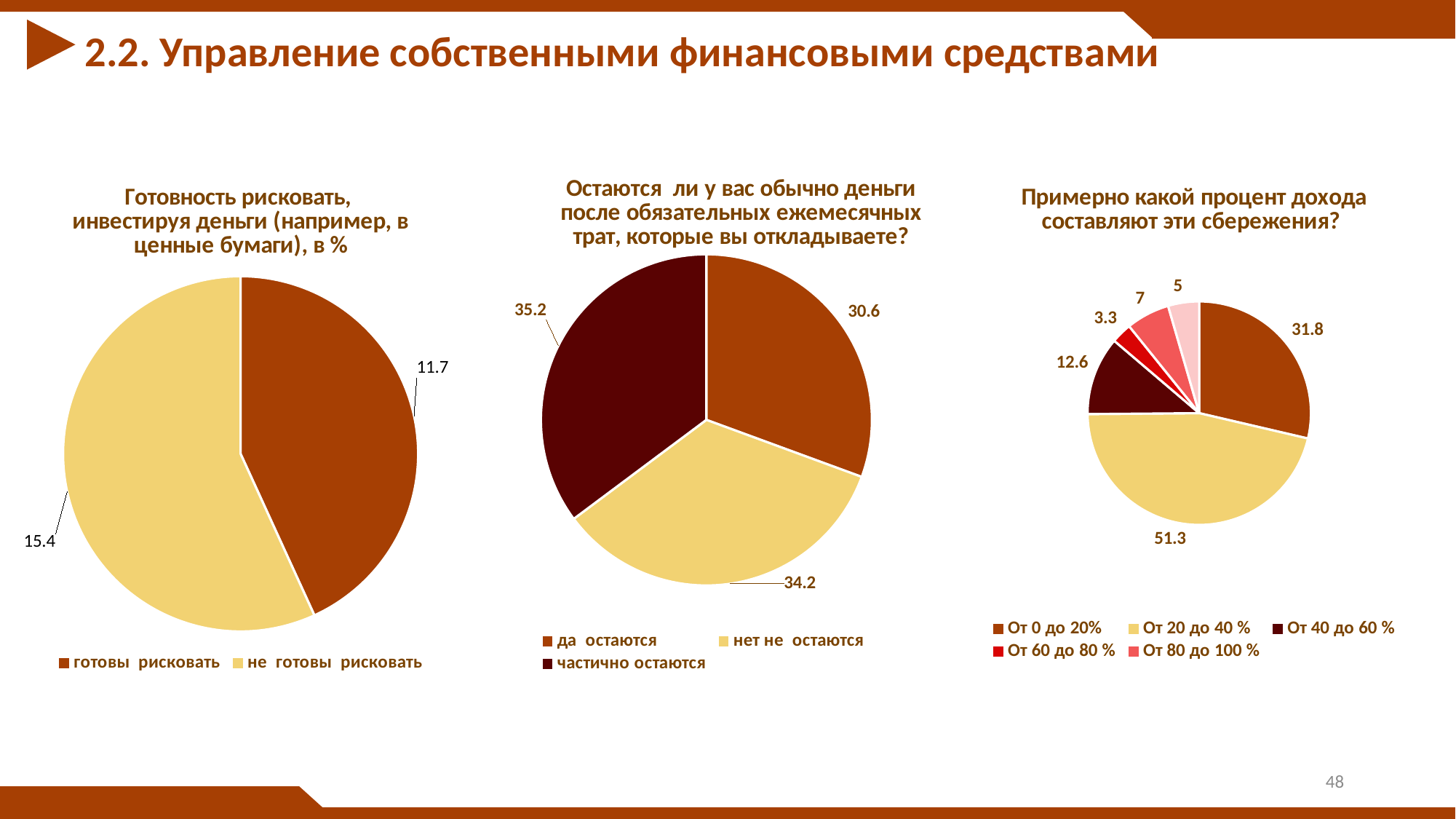
In the left chart (Готовность рисковать, инвестируя деньги), what is the value for "не готовы рисковать"? 15.4 In the left chart (Готовность рисковать, инвестируя деньги), what is the value for "готовы рисковать"? 11.7 In the right chart (Примерно какой процент дохода составляют эти сбережения?), which category has the highest value? От 20 до 40 % In the right chart (Примерно какой процент дохода составляют эти сбережения?), what is the value for "От 20 до 40 %"? 51.3 In the middle chart (Остаются ли у вас обычно деньги после обязательных ежемесячных трат), what is the value for "частично остаются"? 35.2 In the right chart (Примерно какой процент дохода составляют эти сбережения?), which is larger: "От 40 до 60 %" or "От 60 до 80 %"? От 40 до 60 % What kind of chart is the middle chart (Остаются ли у вас обычно деньги после обязательных ежемесячных трат)? pie chart In the middle chart (Остаются ли у вас обычно деньги после обязательных ежемесячных трат), what is the difference between "частично остаются" and "да остаются"? 4.6 In the right chart (Примерно какой процент дохода составляют эти сбережения?), what is the difference between "От 20 до 40 %" and "От 0 до 20%"? 19.5 In the left chart (Готовность рисковать, инвестируя деньги), what is the difference between "не готовы рисковать" and "готовы рисковать"? 3.7 In the middle chart (Остаются ли у вас обычно деньги после обязательных ежемесячных трат), which category has the lowest value? да остаются How many categories does the legend of the middle chart (Остаются ли у вас обычно деньги после обязательных ежемесячных трат) list? 3